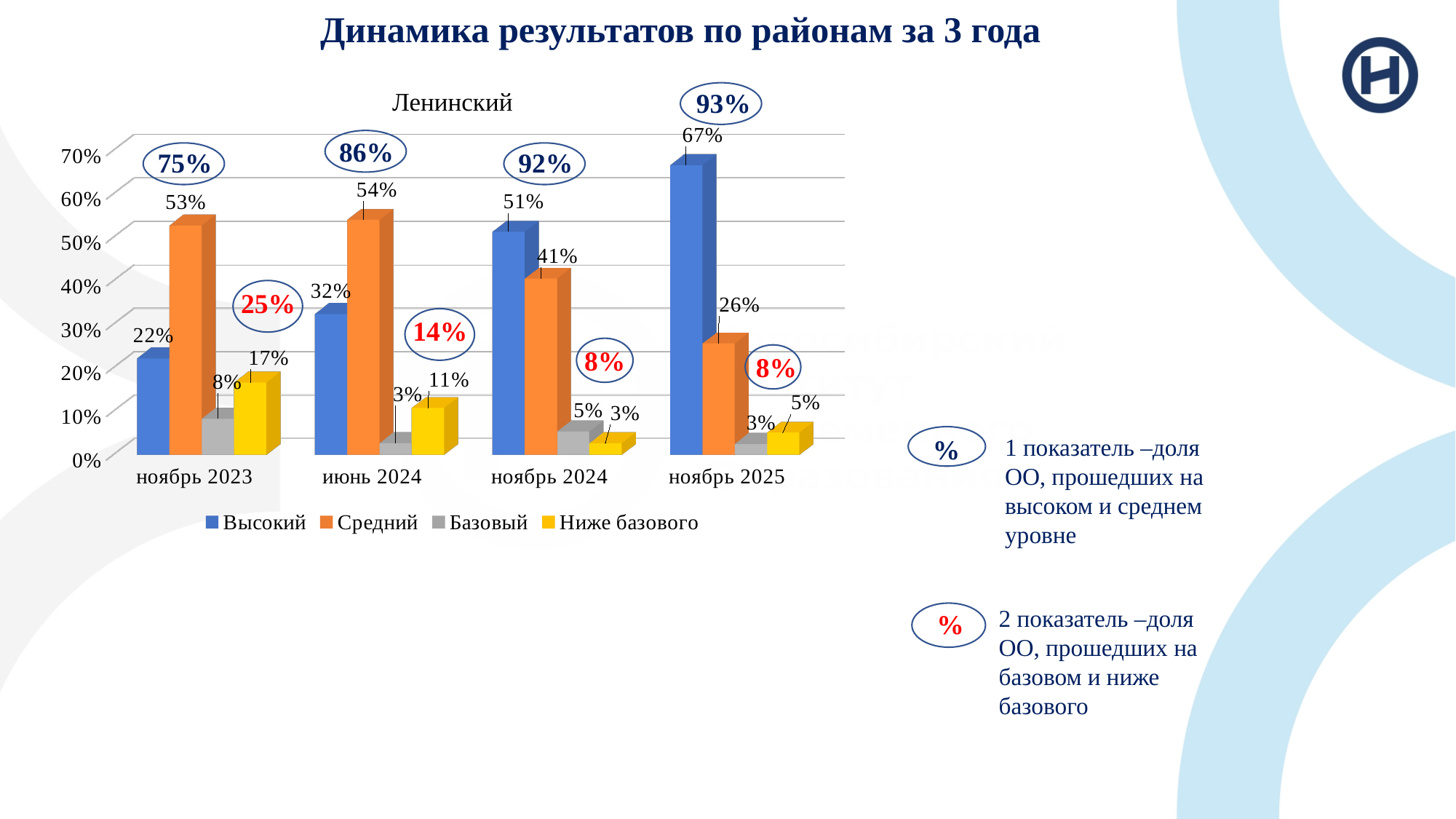
What kind of chart is shown? bar chart Which is larger in ноябрь 2024: Высокий or Средний? Высокий Does the Высокий series rise or fall from ноябрь 2023 to ноябрь 2025? rise How many series does the legend list? 4 In which period is the Средний series lowest? ноябрь 2025 What is the value for Базовый in ноябрь 2024? 5% What is the value for Ниже базового in ноябрь 2023? 17% What is the value for Средний in июнь 2024? 54% What is the difference between Высокий in ноябрь 2025 and Высокий in ноябрь 2023? 45% What is the value for Высокий in ноябрь 2025? 67% In which period is the Высокий series highest? ноябрь 2025 How many periods are shown on the x axis? 4